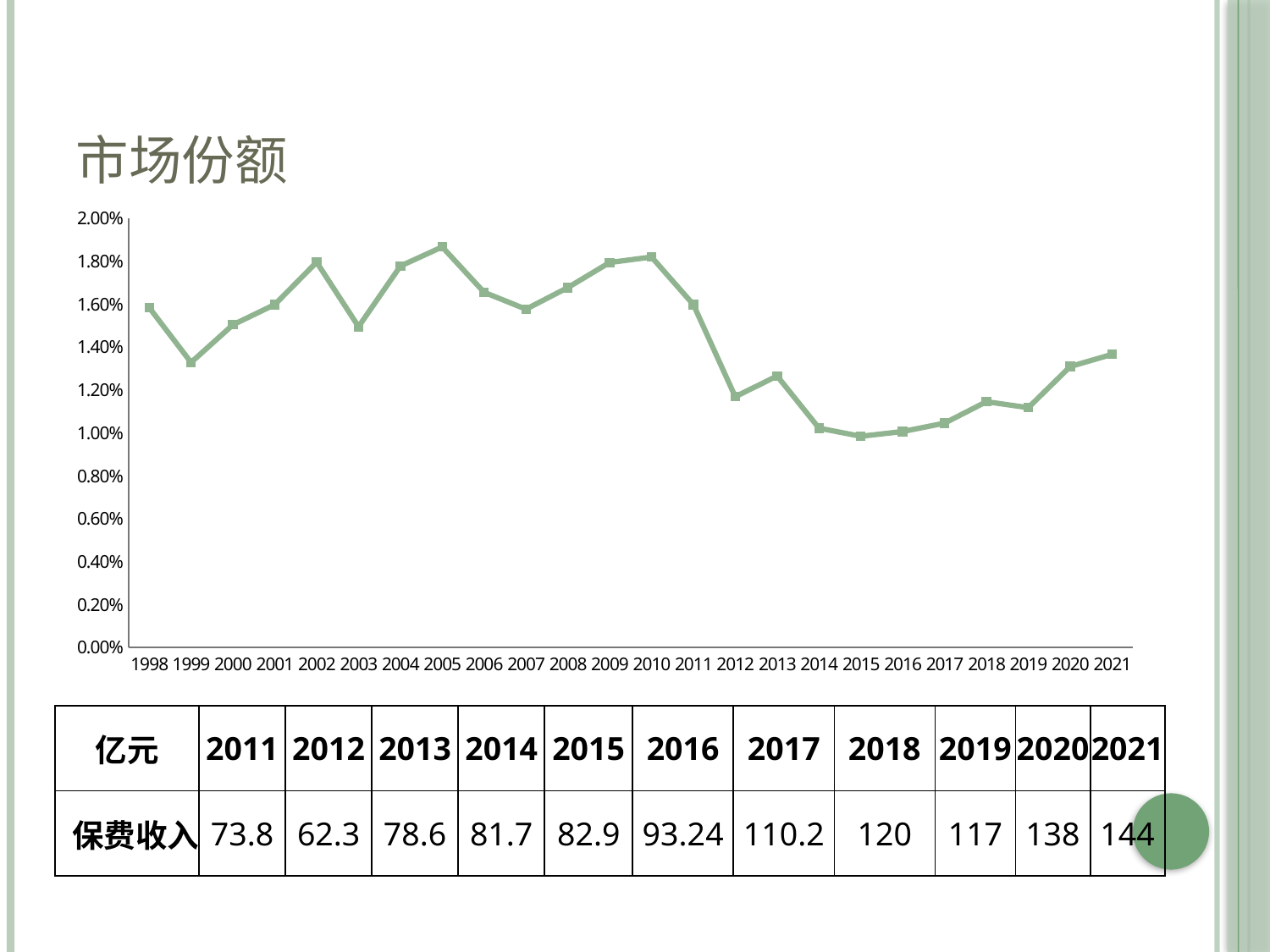
In which year does the 市场份额 line reach its highest value? 2005 In which year does the 市场份额 line reach its lowest value? 2015 Which year has the larger value, 2010 or 2014? 2010 How many years are plotted on the x axis of the 市场份额 chart? 24 Is the value for 2005 greater or less than 1.80%? greater Is the value for 2002 greater or less than 1.60%? greater What is the highest tick label on the y axis of the 市场份额 chart? 2.00% Is the value for 1999 greater or less than 1.40%? less Does the 市场份额 line rise or fall from 2010 to 2015? fall What kind of chart is shown under the title 市场份额? line chart Which year has the larger value, 2002 or 2003? 2002